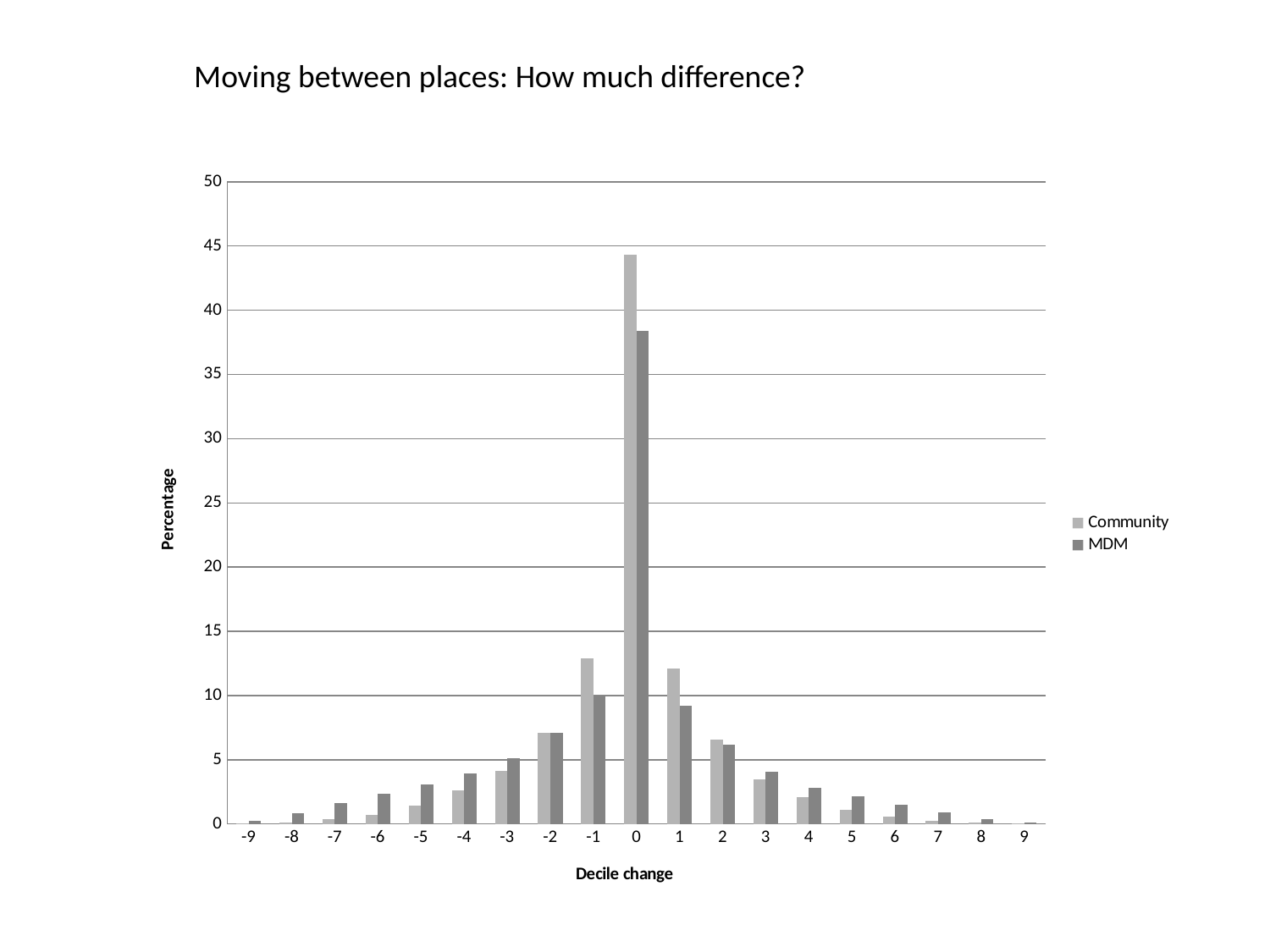
Is the Community value at decile change 0 greater or less than 40? greater Is the Community value at decile change -1 greater or less than 10? greater Is the MDM value at decile change 1 greater or less than 10? less At decile change 0, which series has the larger value, Community or MDM? Community What kind of chart is shown on the slide? bar chart At decile change -5, which series has the larger value, Community or MDM? MDM Which decile change category has the highest Community value? 0 What is the label of the y axis? Percentage Which decile change category has the highest MDM value? 0 How many series does the legend list? 2 How many decile change categories are shown on the x axis? 19